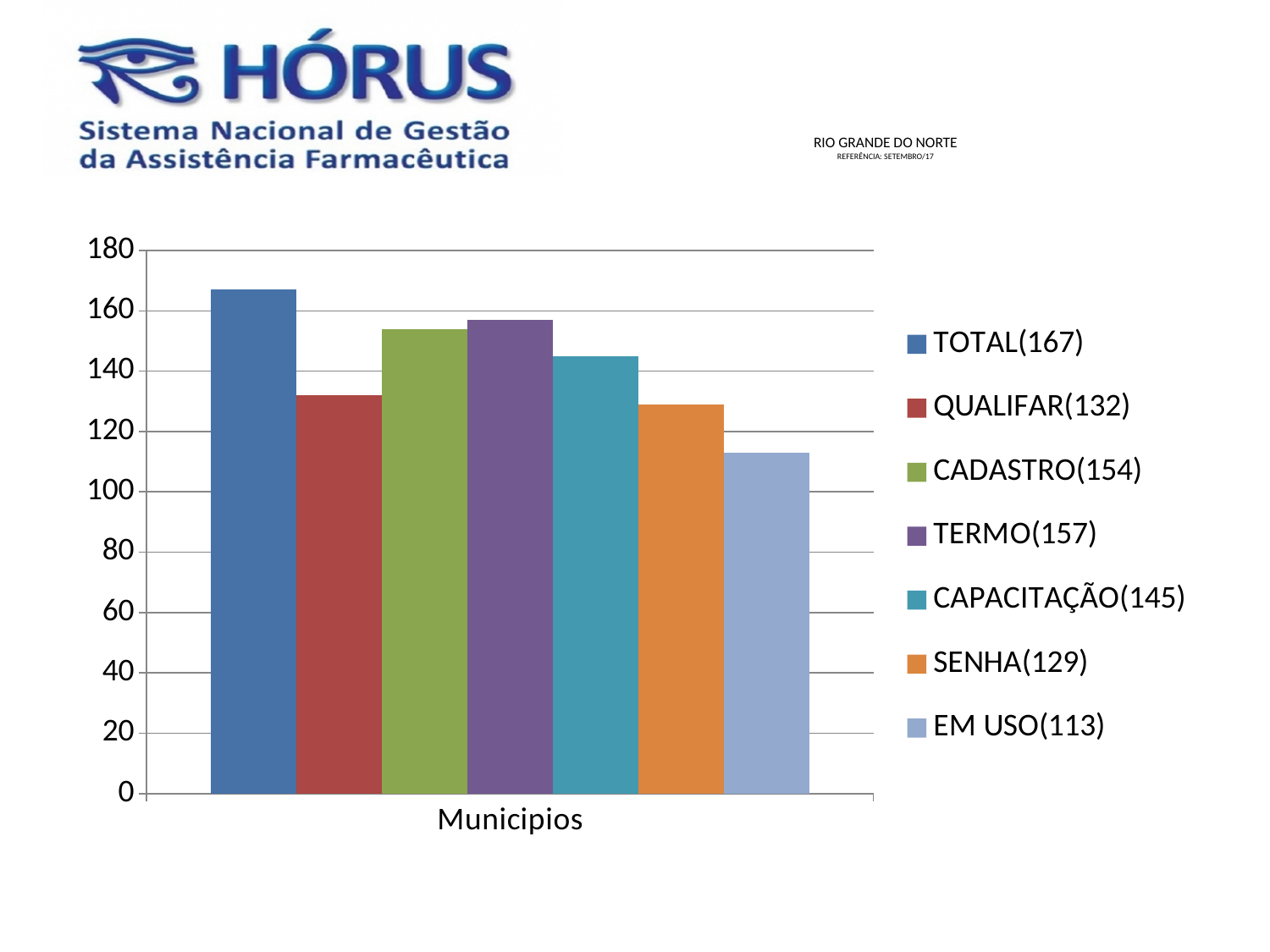
Which series has the highest value? TOTAL Is the value for QUALIFAR greater or less than 140? less Which is larger, the value for SENHA or the value for CAPACITAÇÃO? CAPACITAÇÃO What is the difference between the values for TERMO and CADASTRO? 3 What kind of chart is shown on the slide? bar chart What is the difference between the values for TOTAL and QUALIFAR? 35 Which series has the lowest value? EM USO What is the label on the x axis of the chart? Municipios What is the value for TOTAL? 167 How many series does the legend list? 7 What is the value for EM USO? 113 What is the value for CAPACITAÇÃO? 145